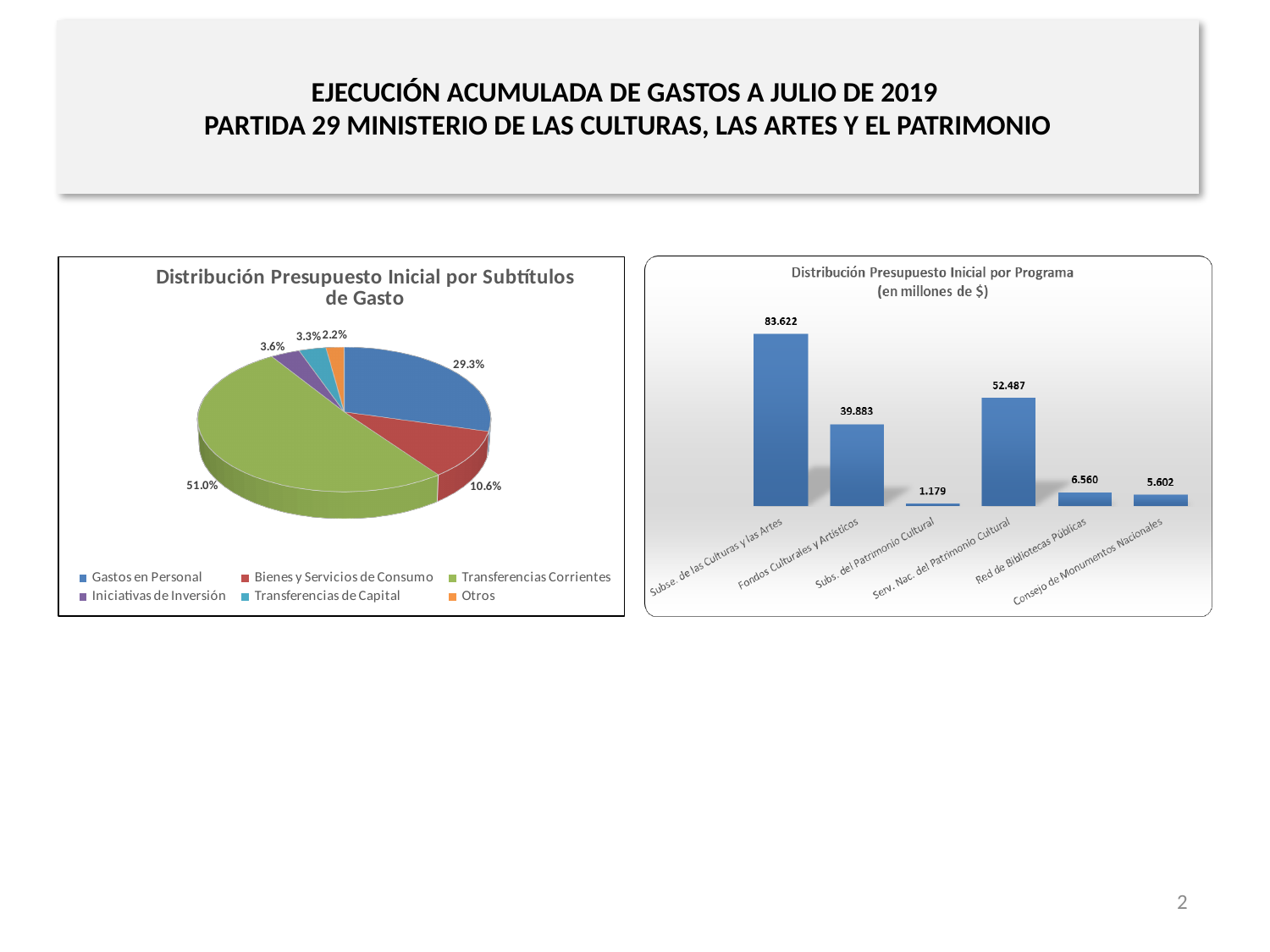
In the 'Distribución Presupuesto Inicial por Subtítulos de Gasto' chart, what share does Gastos en Personal have? 29.3% In the 'Distribución Presupuesto Inicial por Programa' chart, what is the value for Subs. del Patrimonio Cultural? 1.179 What kind of chart is 'Distribución Presupuesto Inicial por Subtítulos de Gasto'? Pie chart In the 'Distribución Presupuesto Inicial por Subtítulos de Gasto' chart, which category has the smallest share? Otros In the 'Distribución Presupuesto Inicial por Programa' chart, which program has the lowest value? Subs. del Patrimonio Cultural In the 'Distribución Presupuesto Inicial por Programa' chart, what is the value for Serv. Nac. del Patrimonio Cultural? 52.487 In the 'Distribución Presupuesto Inicial por Subtítulos de Gasto' chart, how many categories does the legend list? 6 In the 'Distribución Presupuesto Inicial por Programa' chart, which program has the highest value? Subse. de las Culturas y las Artes In the 'Distribución Presupuesto Inicial por Subtítulos de Gasto' chart, what share does Transferencias Corrientes have? 51.0% In the 'Distribución Presupuesto Inicial por Programa' chart, how many programs are shown? 6 In the 'Distribución Presupuesto Inicial por Programa' chart, which is larger: Red de Bibliotecas Públicas or Consejo de Monumentos Nacionales? Red de Bibliotecas Públicas What kind of chart is 'Distribución Presupuesto Inicial por Programa'? Bar chart